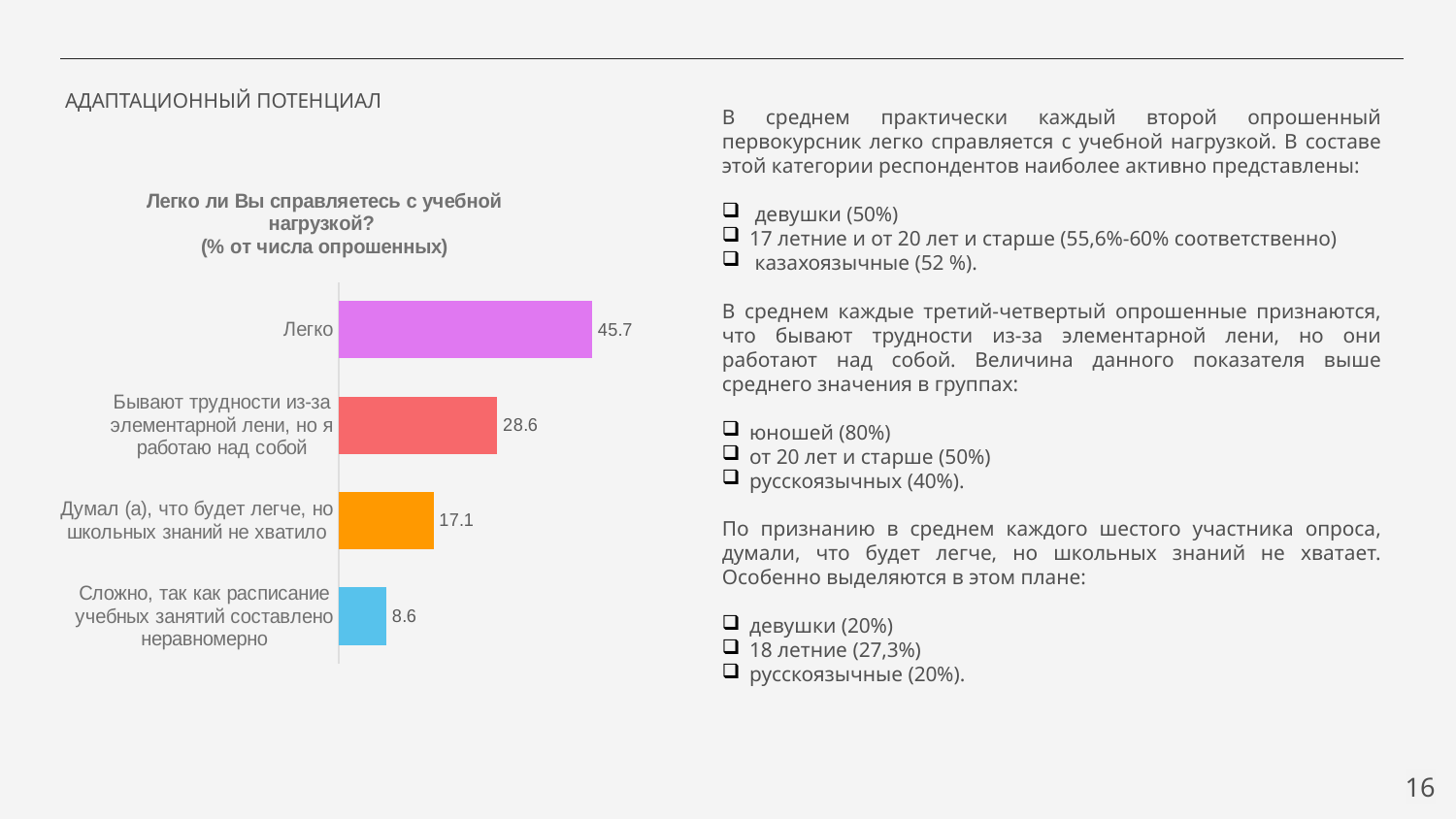
Which is larger: the value for "Бывают трудности из-за элементарной лени, но я работаю над собой" or for "Думал (а), что будет легче, но школьных знаний не хватило"? Бывают трудности из-за элементарной лени, но я работаю над собой What value is shown for "Сложно, так как расписание учебных занятий составлено неравномерно"? 8.6 How many categories are shown in the chart? 4 What is the difference between the values for "Думал (а), что будет легче, но школьных знаний не хватило" and "Сложно, так как расписание учебных занятий составлено неравномерно"? 8.5 What value is shown for the category "Легко"? 45.7 What type of chart is shown on the slide? Bar chart What is the difference between the values for "Легко" and "Бывают трудности из-за элементарной лени, но я работаю над собой"? 17.1 What value is shown for "Думал (а), что будет легче, но школьных знаний не хватило"? 17.1 Which category has the lowest value? Сложно, так как расписание учебных занятий составлено неравномерно What value is shown for "Бывают трудности из-за элементарной лени, но я работаю над собой"? 28.6 Which category has the highest value? Легко What is the title of the chart? Легко ли Вы справляетесь с учебной нагрузкой? (% от числа опрошенных)